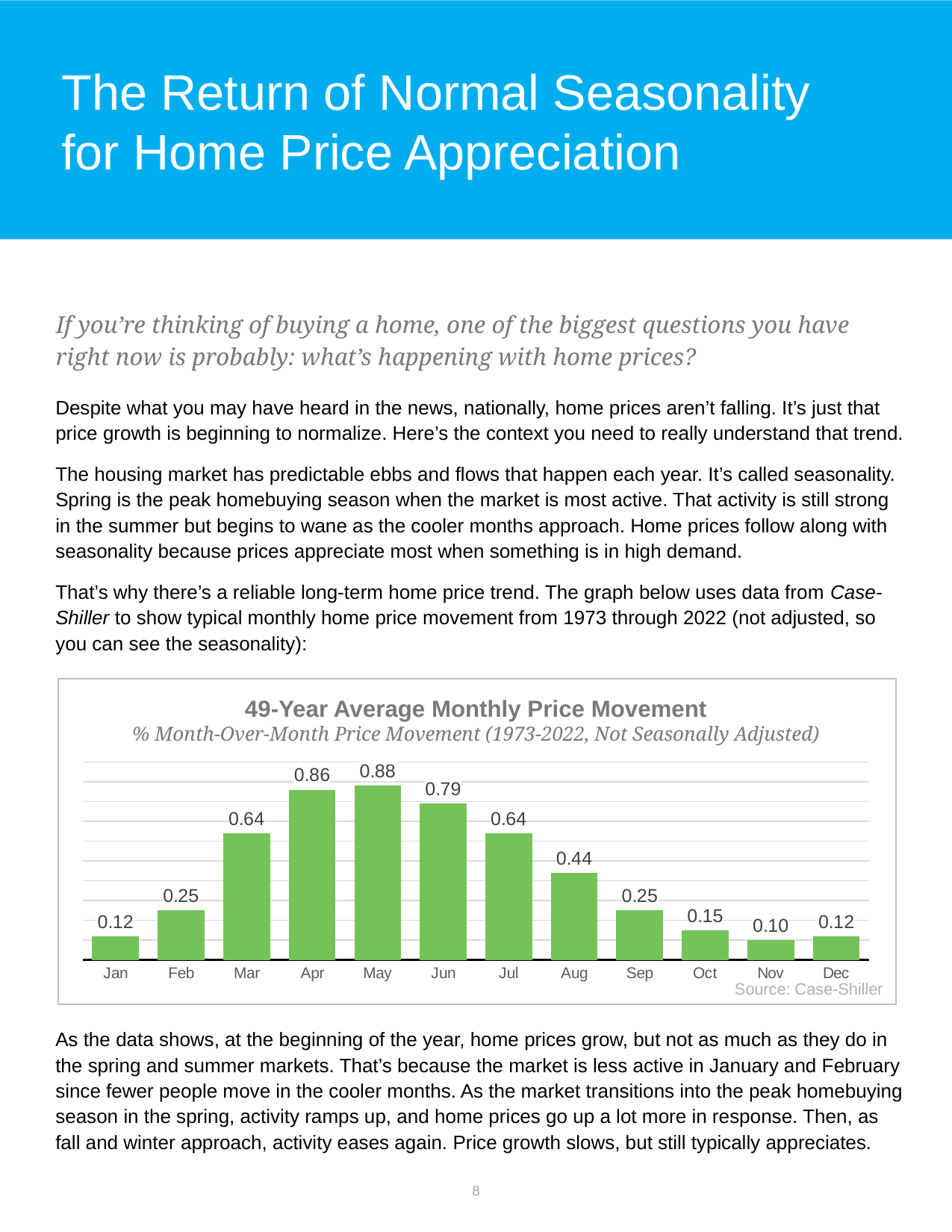
What is the source cited for the chart? Case-Shiller Which is larger, the value for Jun or the value for Jul? Jun Do the values rise or fall from May through Nov? Fall What is the value for May in the 49-Year Average Monthly Price Movement chart? 0.88 What is the value for Jan in the chart? 0.12 What is the difference between the values for Apr and Mar? 0.22 What is the difference between the values for May and Nov? 0.78 Which month has the highest value in the chart? May How many months are shown on the x axis of the chart? 12 What kind of chart is shown on the slide? Bar chart What is the value for Aug in the chart? 0.44 Which month has the lowest value in the chart? Nov